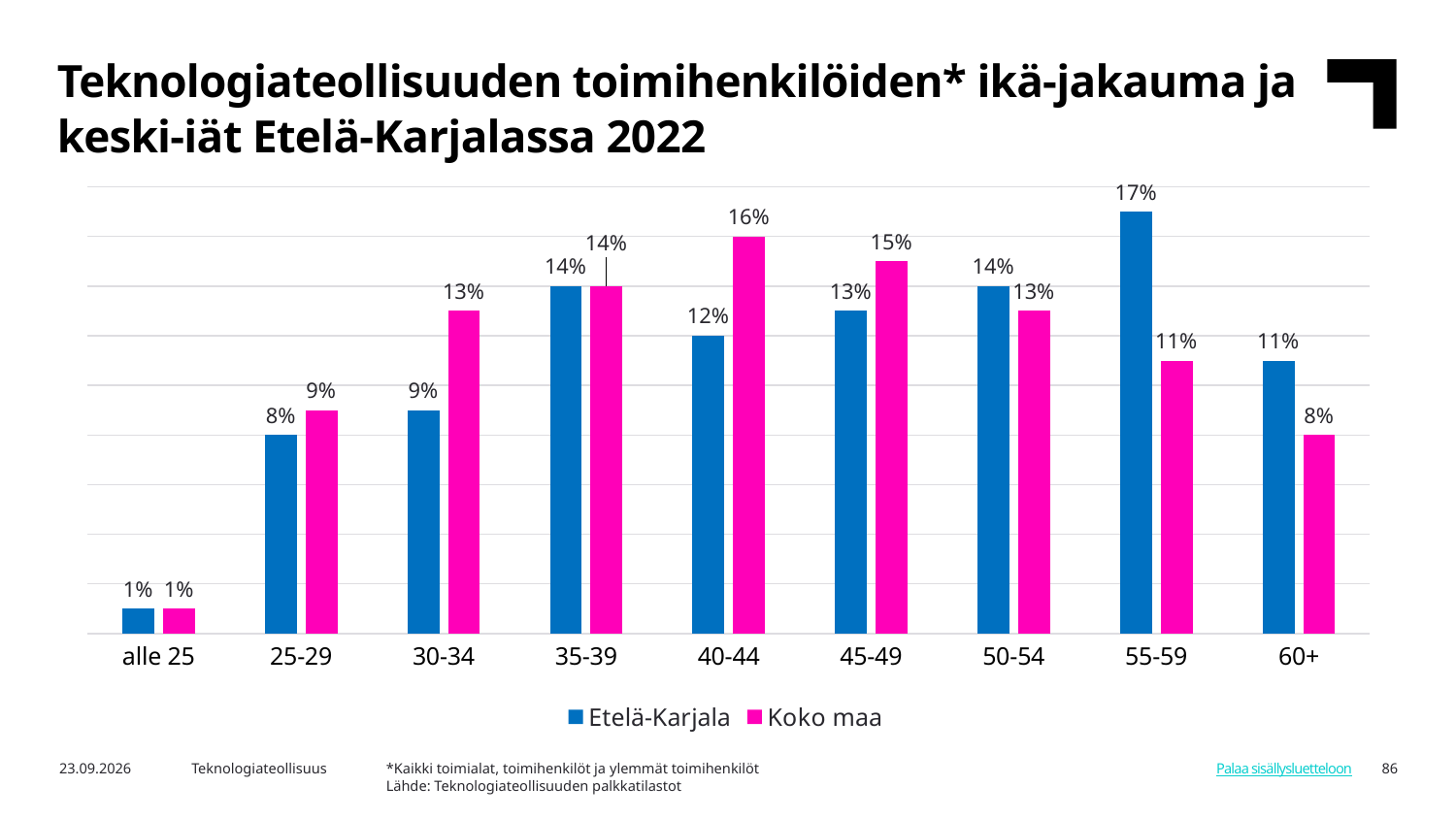
Which age group has the highest value for Etelä-Karjala? 55-59 Which age group has the lowest value for Koko maa? alle 25 What is the value for Etelä-Karjala in the 55-59 age group? 17% What is the difference between Etelä-Karjala and Koko maa in the 55-59 age group? 6% How many age categories are shown on the x axis? 9 In the 30-34 age group, which series has the larger value, Etelä-Karjala or Koko maa? Koko maa What is the value for Koko maa in the 40-44 age group? 16% Which age group has the highest value for Koko maa? 40-44 What is the value for Etelä-Karjala in the 60+ age group? 11% What kind of chart is shown on the slide? Bar chart How many series does the legend list? 2 Which series is shown in magenta in the legend? Koko maa